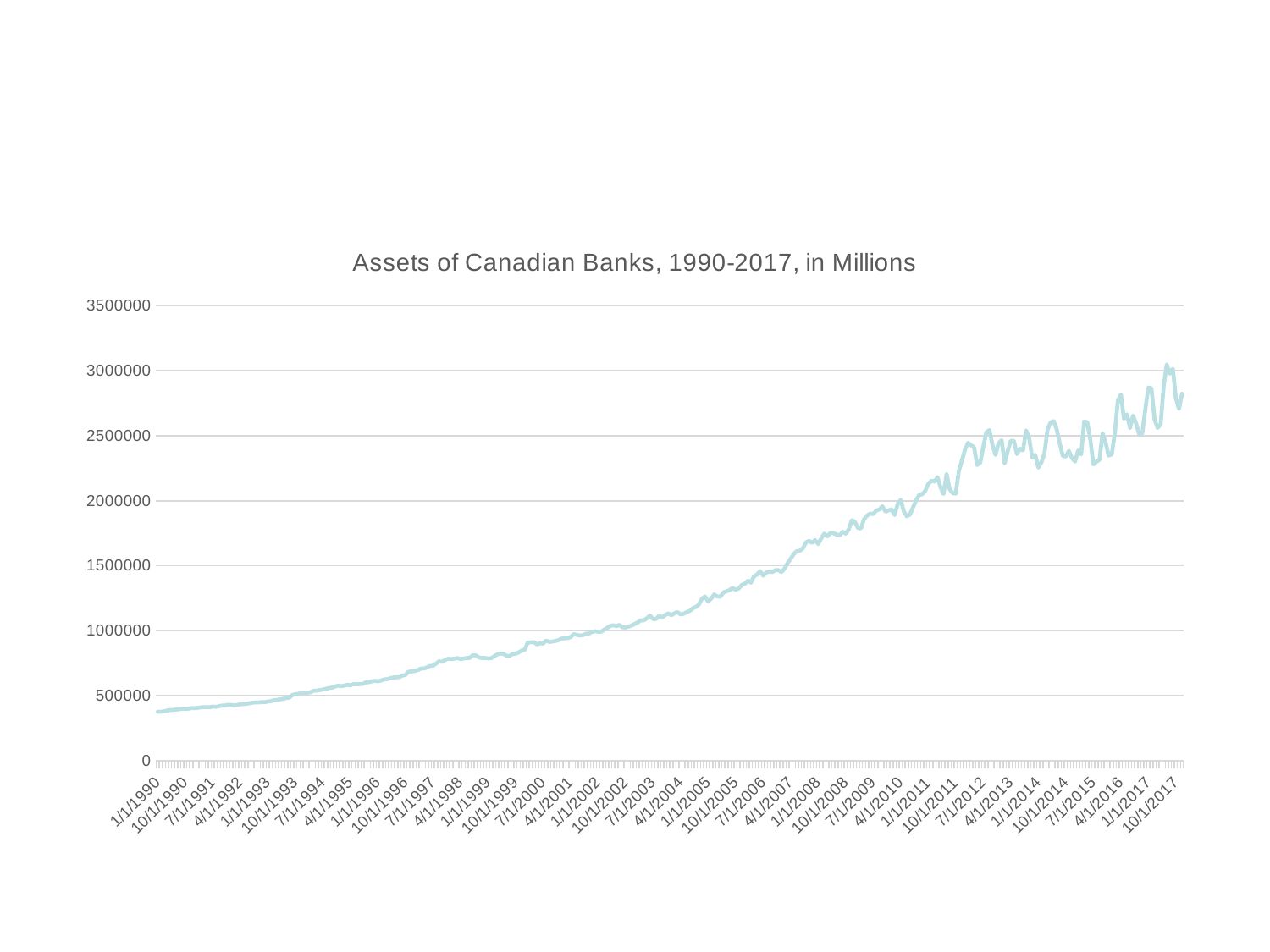
Is the value for 1/1/2000 greater or less than 1000000? less Is the value for 10/1/2017 greater or less than 2500000? greater Do the values generally rise or fall from 1/1/1990 to 10/1/2017? rise Which is larger, the value for 1/1/1996 or the value for 1/1/2006? 1/1/2006 Is the value for 1/1/2008 greater or less than 1500000? greater What is the highest value shown on the vertical axis? 3500000 What kind of chart is shown on the slide? line chart What is the title of the chart? Assets of Canadian Banks, 1990-2017, in Millions Which is larger, the value for 1/1/1990 or the value for 10/1/2017? 10/1/2017